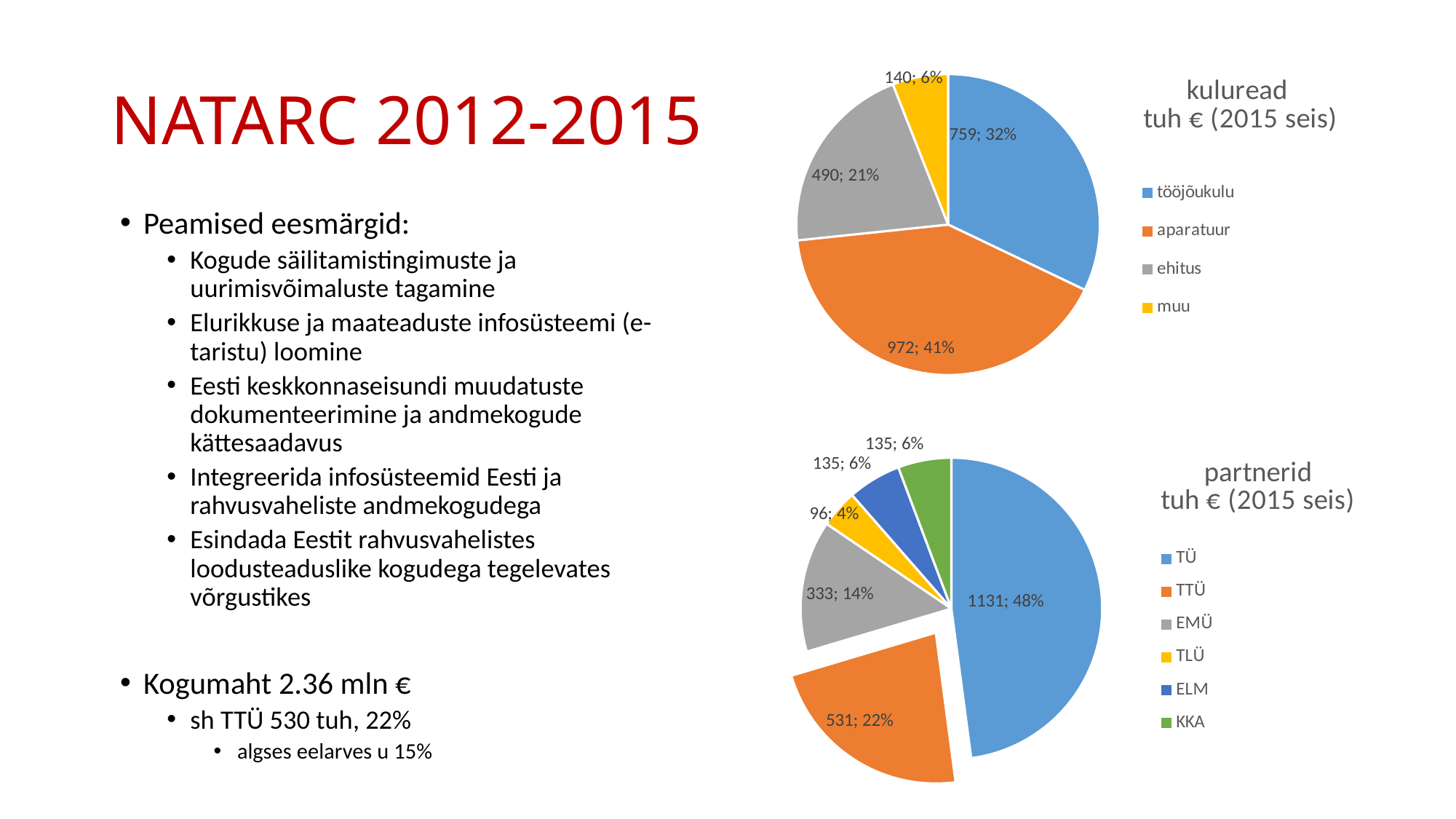
In the 'partnerid tuh € (2015 seis)' chart, what share of the pie is TTÜ? 22% In the 'kuluread tuh € (2015 seis)' chart, which category has the smallest slice? muu In the 'kuluread tuh € (2015 seis)' chart, what share of the pie is ehitus? 21% In the 'partnerid tuh € (2015 seis)' chart, what value is shown for TÜ? 1131 In the 'kuluread tuh € (2015 seis)' chart, what value is shown for aparatuur? 972 In the 'kuluread tuh € (2015 seis)' chart, which category has the largest slice? aparatuur In the 'partnerid tuh € (2015 seis)' chart, which partner has the smallest slice? TLÜ How many categories does the 'kuluread tuh € (2015 seis)' chart show? 4 What type of chart is the 'partnerid tuh € (2015 seis)' chart? pie chart In the 'kuluread tuh € (2015 seis)' chart, what is the difference between the values for aparatuur and tööjõukulu? 213 In the 'partnerid tuh € (2015 seis)' chart, which is larger, the value for EMÜ or the value for TLÜ? EMÜ How many entries does the legend of the 'partnerid tuh € (2015 seis)' chart list? 6